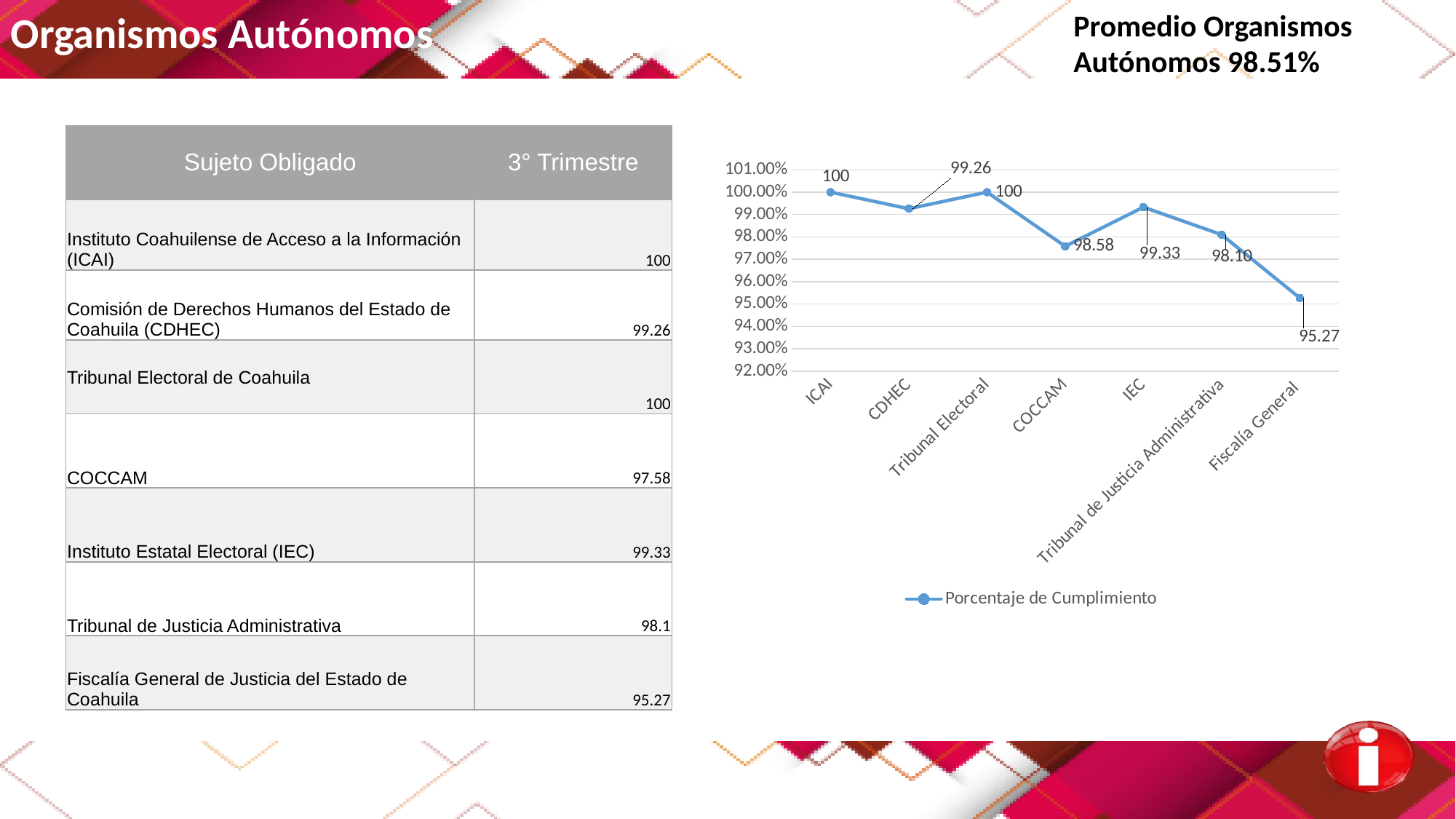
What is the difference between the values for ICAI and Fiscalía General in the line chart? 4.73 What is the value for CDHEC in the line chart? 99.26 Which is larger in the line chart, the value for IEC or the value for Tribunal de Justicia Administrativa? IEC How many series does the legend of the line chart list? 1 What is the value for ICAI in the line chart? 100 What is the value for Fiscalía General in the line chart? 95.27 What is the value for Tribunal de Justicia Administrativa in the line chart? 98.10 What kind of chart is shown on the slide? line chart Is the value for Fiscalía General in the line chart greater or less than 96.00%? less Which category has the lowest value in the line chart? Fiscalía General How many categories are plotted on the x axis of the line chart? 7 What is the value for IEC in the line chart? 99.33